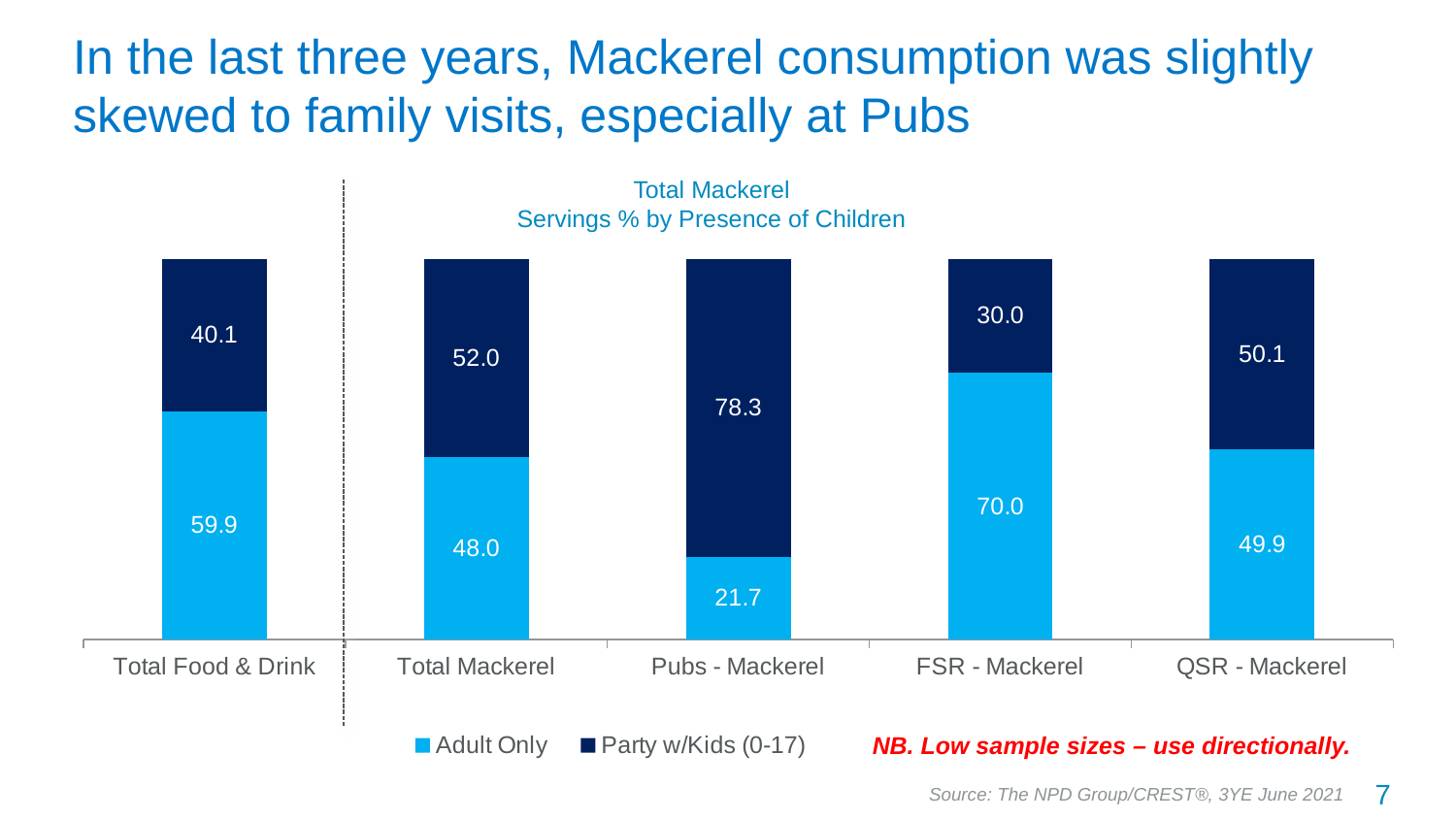
Which category has the highest Party w/Kids (0-17) value? Pubs - Mackerel What is the difference between the Adult Only and Party w/Kids (0-17) values for Total Mackerel? 4.0 What is the title of the chart? Total Mackerel Servings % by Presence of Children Which is larger for FSR - Mackerel: the Adult Only value or the Party w/Kids (0-17) value? Adult Only Which category has the lowest Adult Only value? Pubs - Mackerel What kind of chart is shown on the slide? Stacked bar chart What is the Party w/Kids (0-17) value for QSR - Mackerel? 50.1 What is the Adult Only value for Total Food & Drink? 59.9 What is the Party w/Kids (0-17) value for FSR - Mackerel? 30.0 How many categories are shown on the x axis? 5 How many series does the legend list? 2 What is the Adult Only value for Pubs - Mackerel? 21.7